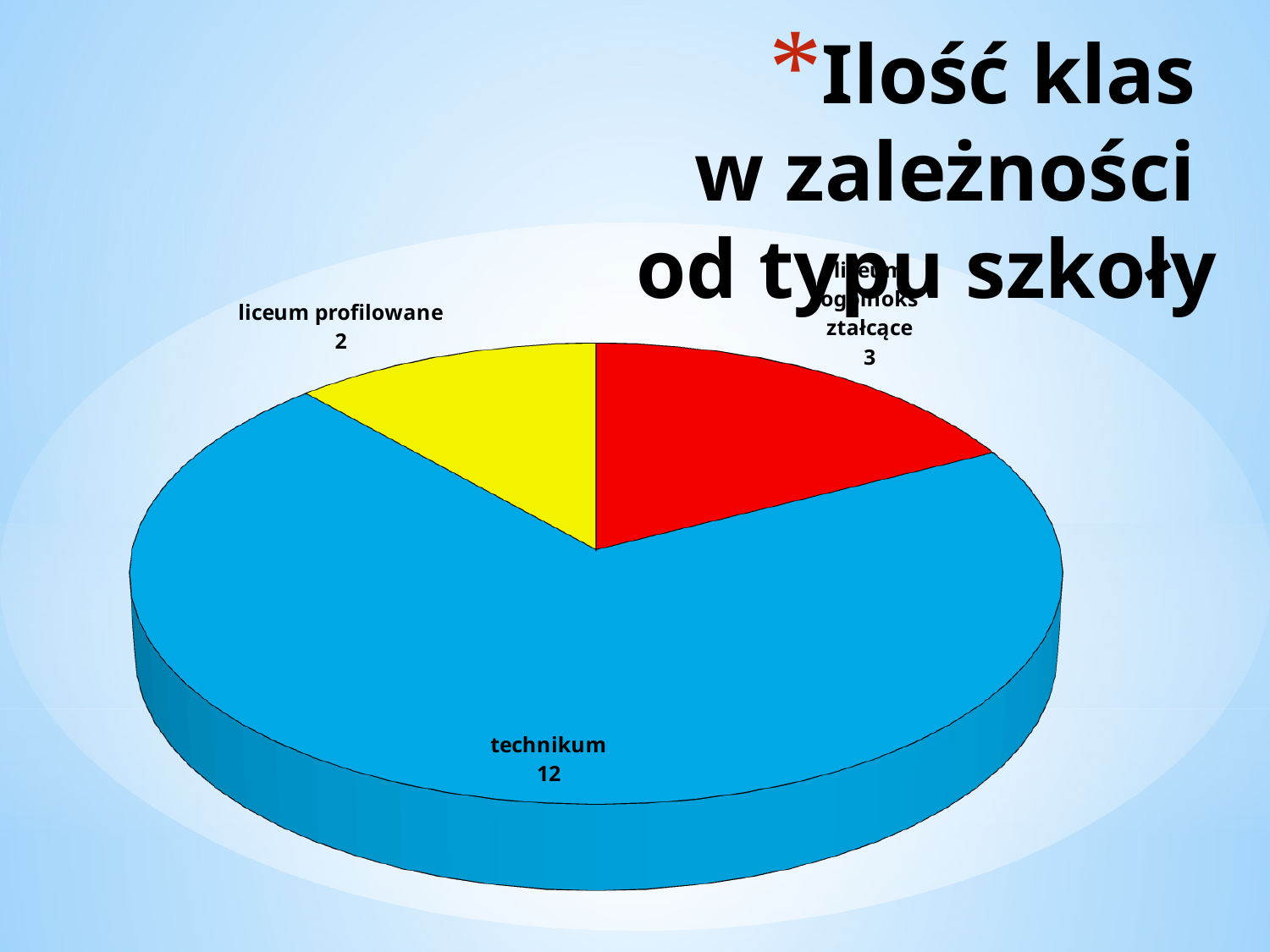
How many slices does the pie chart have? 3 Which school type has the smallest slice of the pie? liceum profilowane Which school type has the largest slice of the pie? technikum What type of chart is shown on the slide? pie chart What is the title of the slide? Ilość klas w zależności od typu szkoły What is the difference between the number of classes for technikum and for liceum profilowane? 10 What is the total number of classes across all slices of the pie? 17 How many classes are shown for technikum? 12 What value is shown for the red slice of the pie? 3 How many classes are shown for liceum profilowane? 2 Which is larger: the value for technikum or the value for liceum profilowane? technikum What colour is the technikum slice? blue